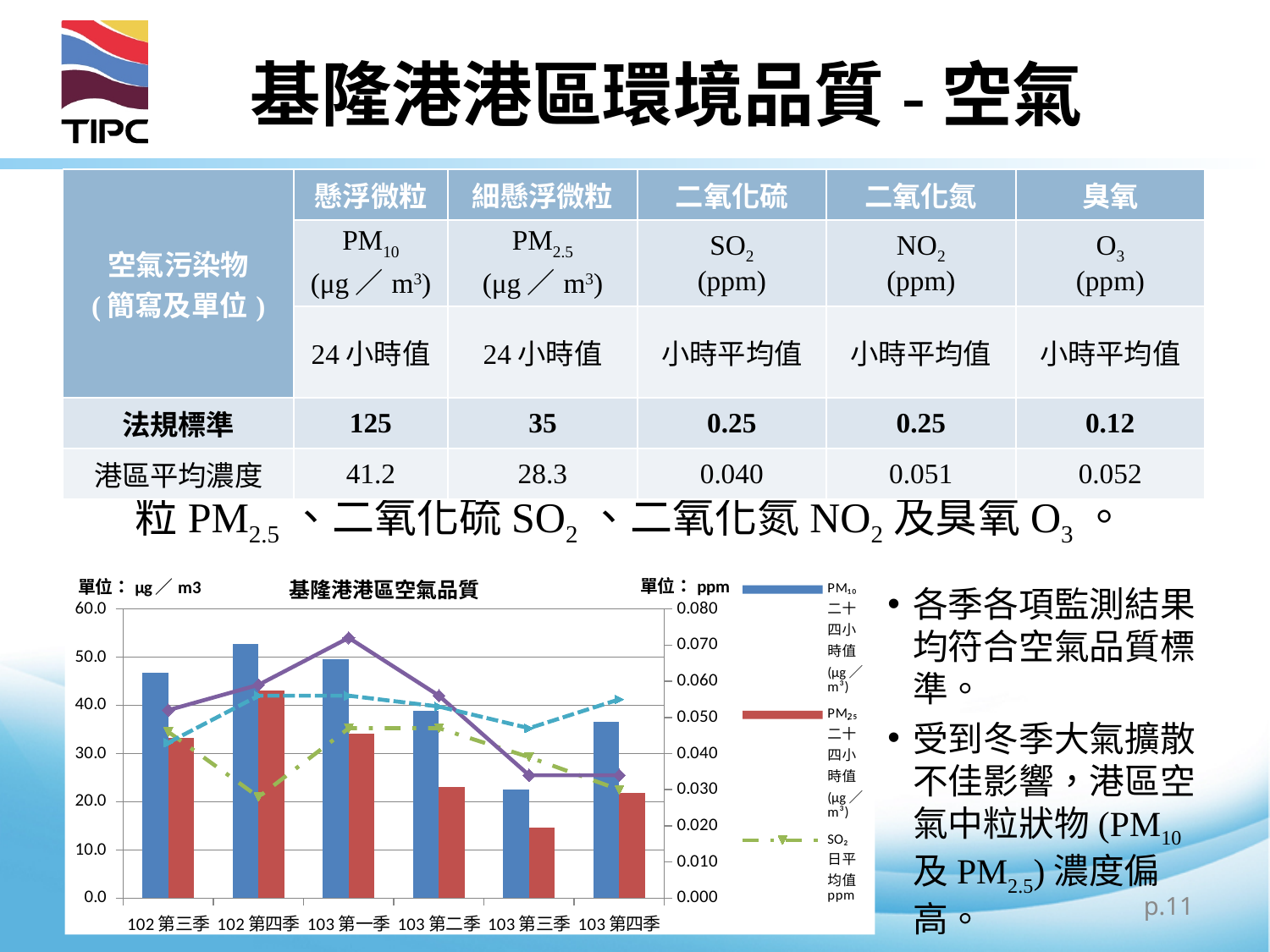
Is the PM₁₀ value for 102 第四季 greater or less than 50.0? greater Is the PM₂.₅ value for 103 第三季 greater or less than 20.0? less In which quarter is the PM₂.₅ bar the lowest? 103 第三季 Is the PM₁₀ value for 103 第三季 greater or less than 30.0? less In 103 第二季, which is larger, the PM₁₀ bar or the PM₂.₅ bar? PM₁₀ What unit is shown for the left vertical axis of the chart? μg／m3 How many quarters (categories) are shown on the x axis of the chart? 6 In which quarter is the PM₂.₅ bar the highest? 102 第四季 What is the title of the chart on the slide? 基隆港港區空氣品質 In which quarter is the PM₁₀ bar the lowest? 103 第三季 Do the PM₁₀ bars rise or fall from 102 第四季 to 103 第三季? fall In which quarter is the PM₁₀ bar the highest? 102 第四季